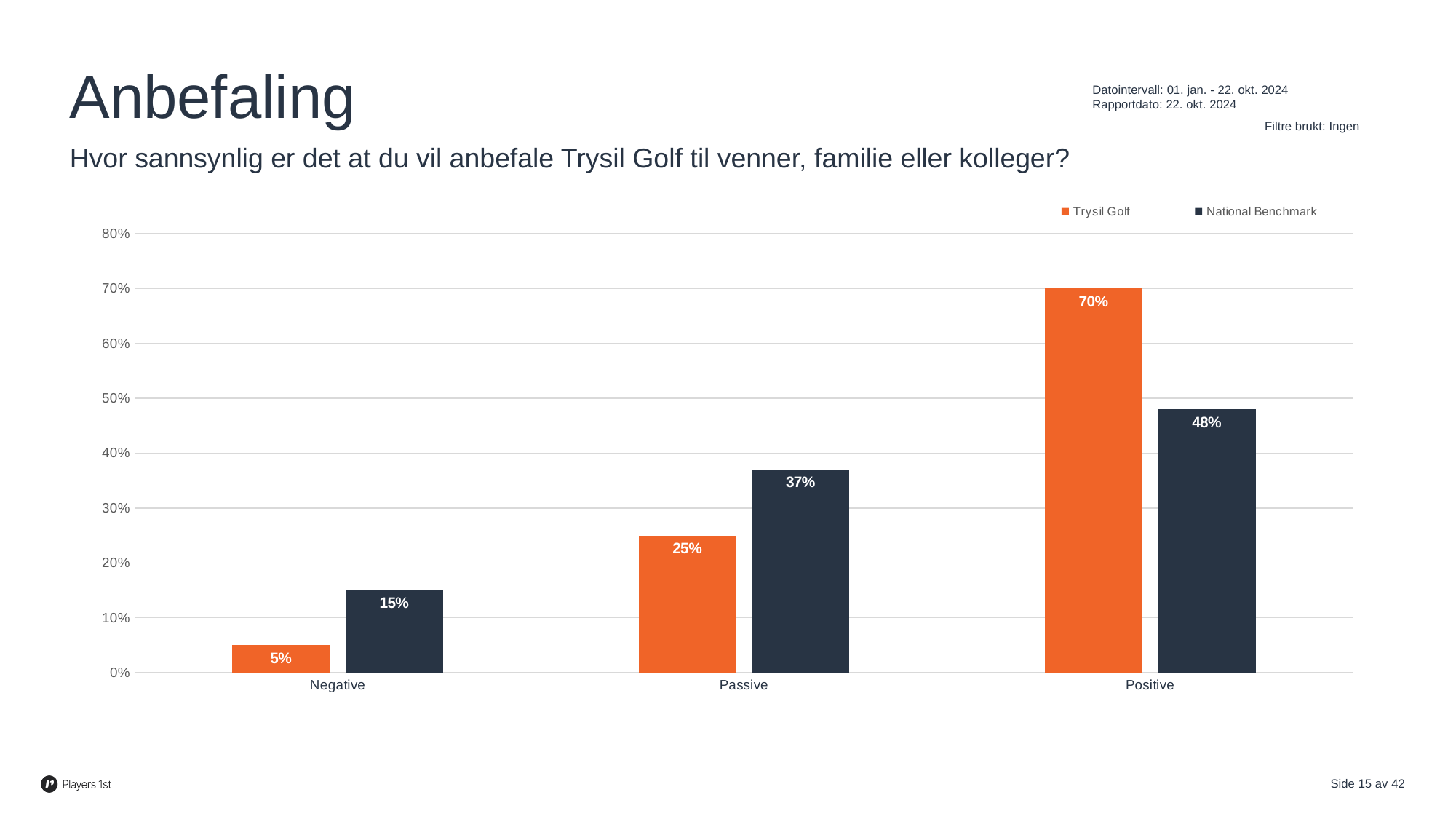
Which colour represents Trysil Golf in the chart? Orange What kind of chart is shown on the slide? Bar chart How many series does the legend list? 2 For Passive, which is larger: Trysil Golf or National Benchmark? National Benchmark How many categories are shown on the x axis? 3 What is the Trysil Golf value for Positive? 70% Which category has the lowest National Benchmark value? Negative What is the difference between the Trysil Golf and National Benchmark values for Positive? 22% What is the National Benchmark value for Positive? 48% What is the National Benchmark value for Passive? 37% Which category has the highest Trysil Golf value? Positive What is the Trysil Golf value for Negative? 5%